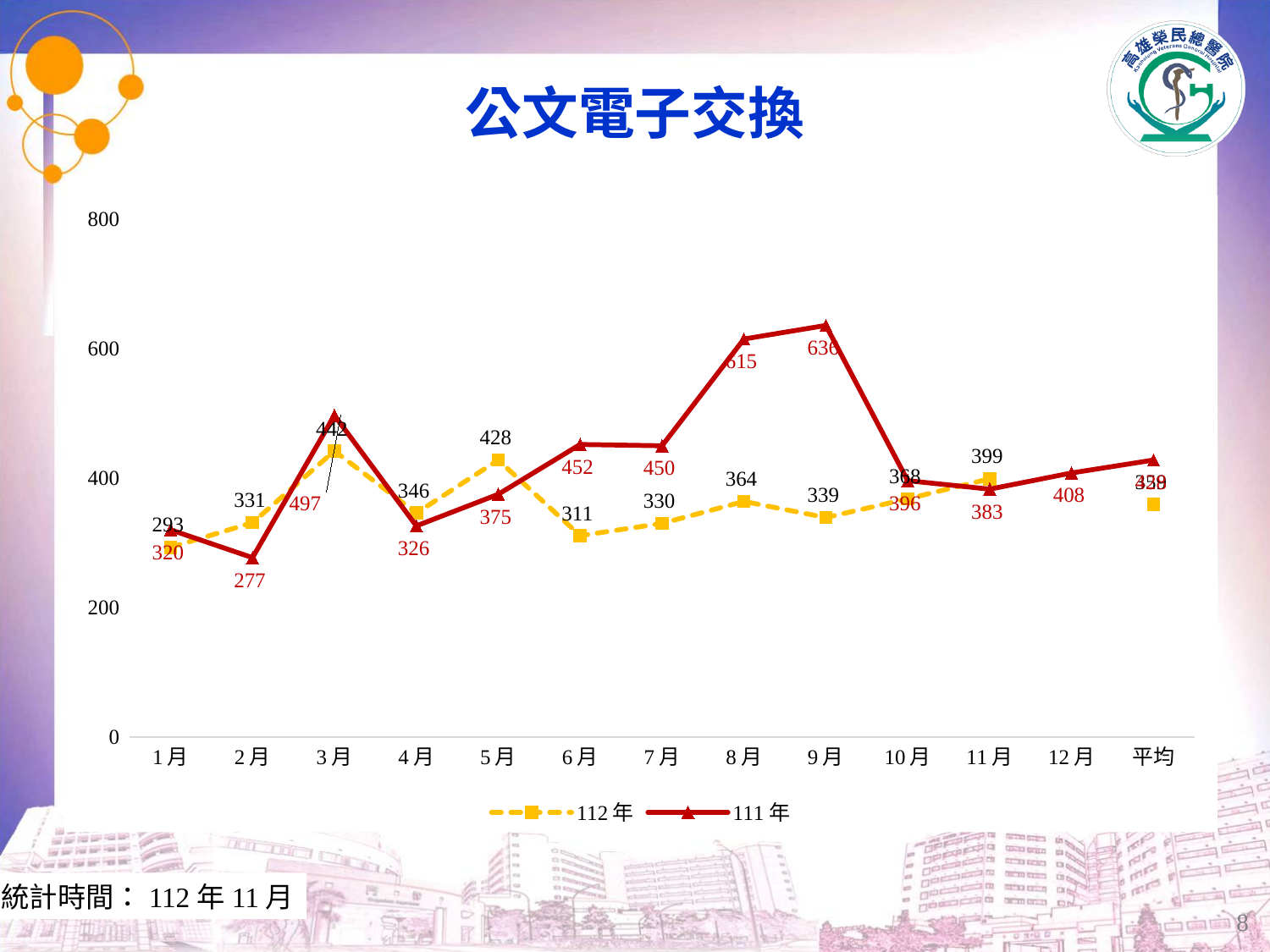
What is the value for 112年 in 5月? 428 What is the value for 111年 in 12月? 408 In which month is the 111年 series lowest? 2月 What kind of chart is shown on the slide? line chart What is the difference between the 111年 values for 9月 and 8月? 21 In 7月, which series has the larger value, 111年 or 112年? 111年 In which month is the 111年 series highest? 9月 How many categories are shown on the x axis? 13 In which month is the 112年 series highest? 3月 How many series does the legend list? 2 Is the value for 111年 in 8月 greater or less than 600? greater What is the value for 111年 in 2月? 277